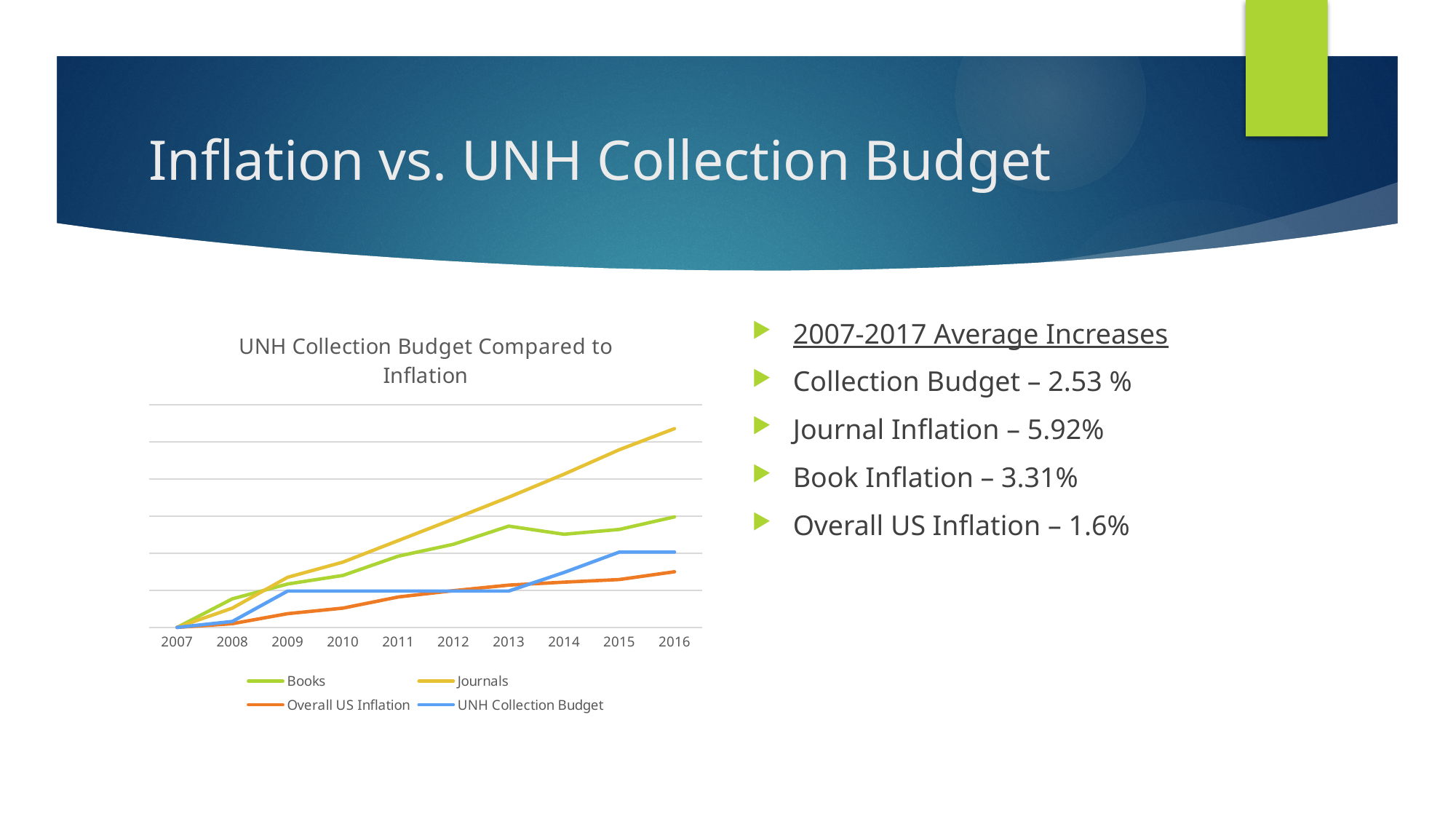
Which series is drawn in blue in the chart? UNH Collection Budget In 2011, which is higher: Journals or Overall US Inflation? Journals In 2016, which is higher: Journals or Books? Journals Does the UNH Collection Budget line rise, fall or stay flat between 2009 and 2013? Stays flat Which series has the highest value in 2016? Journals What is the title of the chart? UNH Collection Budget Compared to Inflation In 2016, which is higher: Books or UNH Collection Budget? Books What kind of chart is shown on the slide? Line chart Does the Journals line rise or fall from 2007 to 2016? Rises How many series does the chart legend list? 4 Which series has the lowest value in 2016? Overall US Inflation How many years are plotted along the x axis of the chart? 10